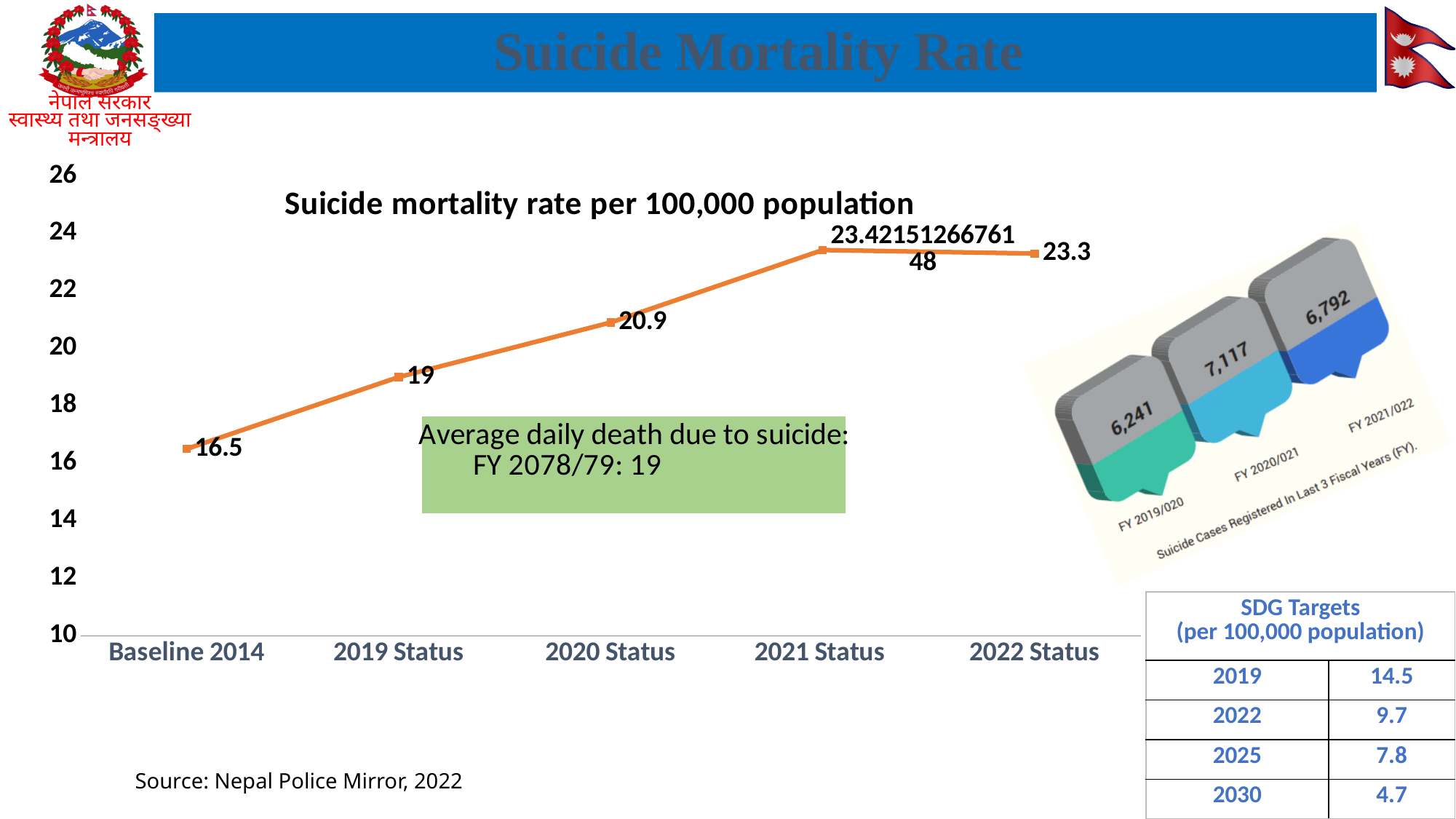
What is the suicide mortality rate per 100,000 population at Baseline 2014? 16.5 What is the difference between the suicide mortality rate for 2020 Status and 2019 Status? 1.9 By how much did the suicide mortality rate increase from Baseline 2014 to 2022 Status? 6.8 How many data points are plotted in the suicide mortality rate line chart? 5 Does the suicide mortality rate rise or fall from Baseline 2014 to 2021 Status? rise Which category has the highest suicide mortality rate in the line chart? 2021 Status What type of chart is shown on the slide for the suicide mortality rate? line chart Is the suicide mortality rate for 2019 Status greater or less than 20? less What is the title of the line chart on the slide? Suicide mortality rate per 100,000 population What is the suicide mortality rate per 100,000 population for 2020 Status? 20.9 Which category has the lowest suicide mortality rate in the line chart? Baseline 2014 What is the suicide mortality rate per 100,000 population for 2022 Status? 23.3